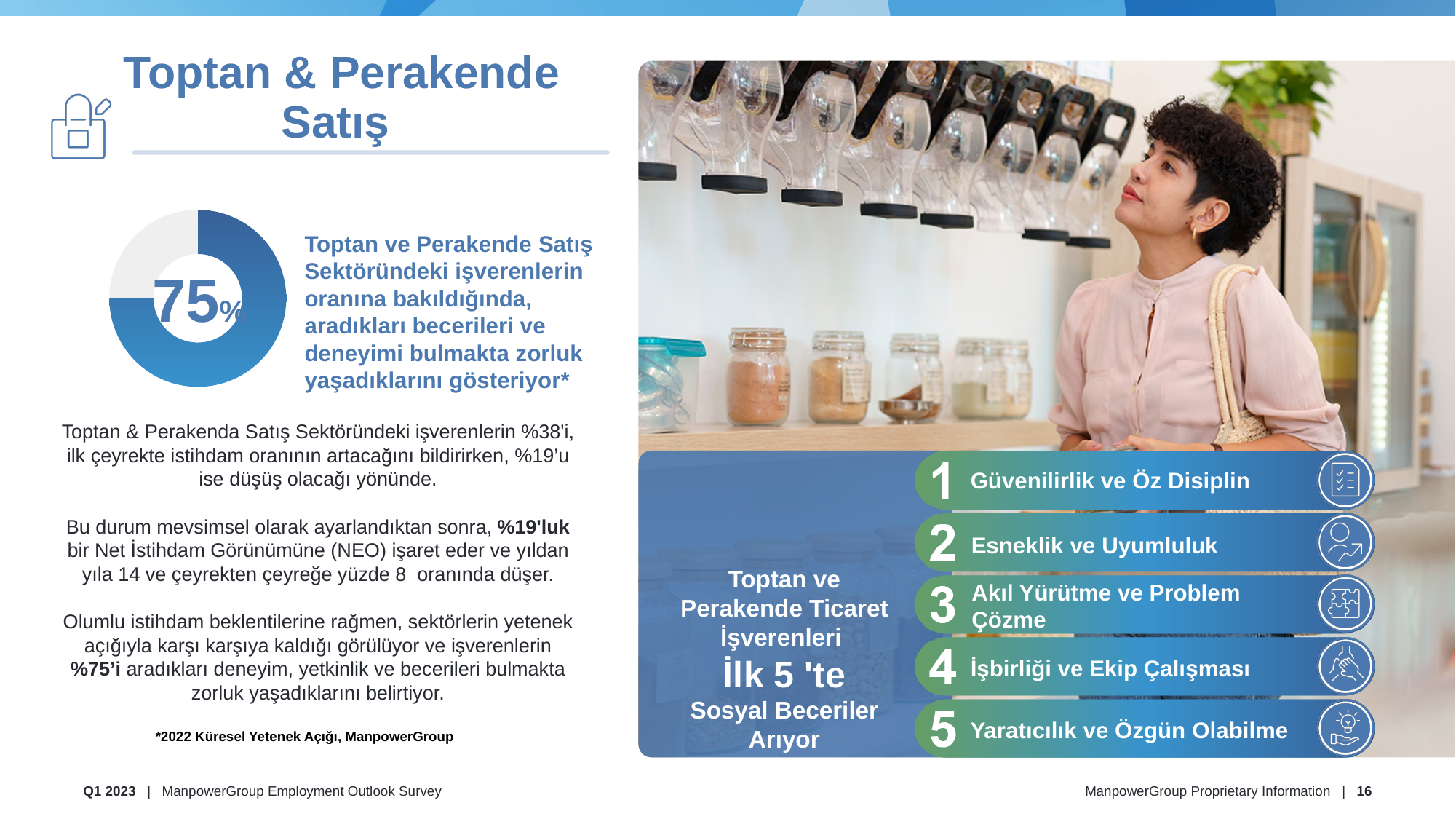
How many segments does the donut chart have? 2 What percentage is printed in the centre of the donut chart? 75% What share of the donut chart does the blue (filled) segment represent? 75% What kind of chart is shown on the left of the slide? Donut (pie) chart What colour is the segment of the donut chart that represents 75%? Blue Which segment of the donut chart is larger, the blue one or the grey one? The blue one Which segment of the donut chart is the smallest? The grey segment Is the value shown in the donut chart greater or less than 50%? greater According to the text next to the donut chart, what does the 75% represent? The share of Wholesale & Retail employers having difficulty finding the skills and experience they seek